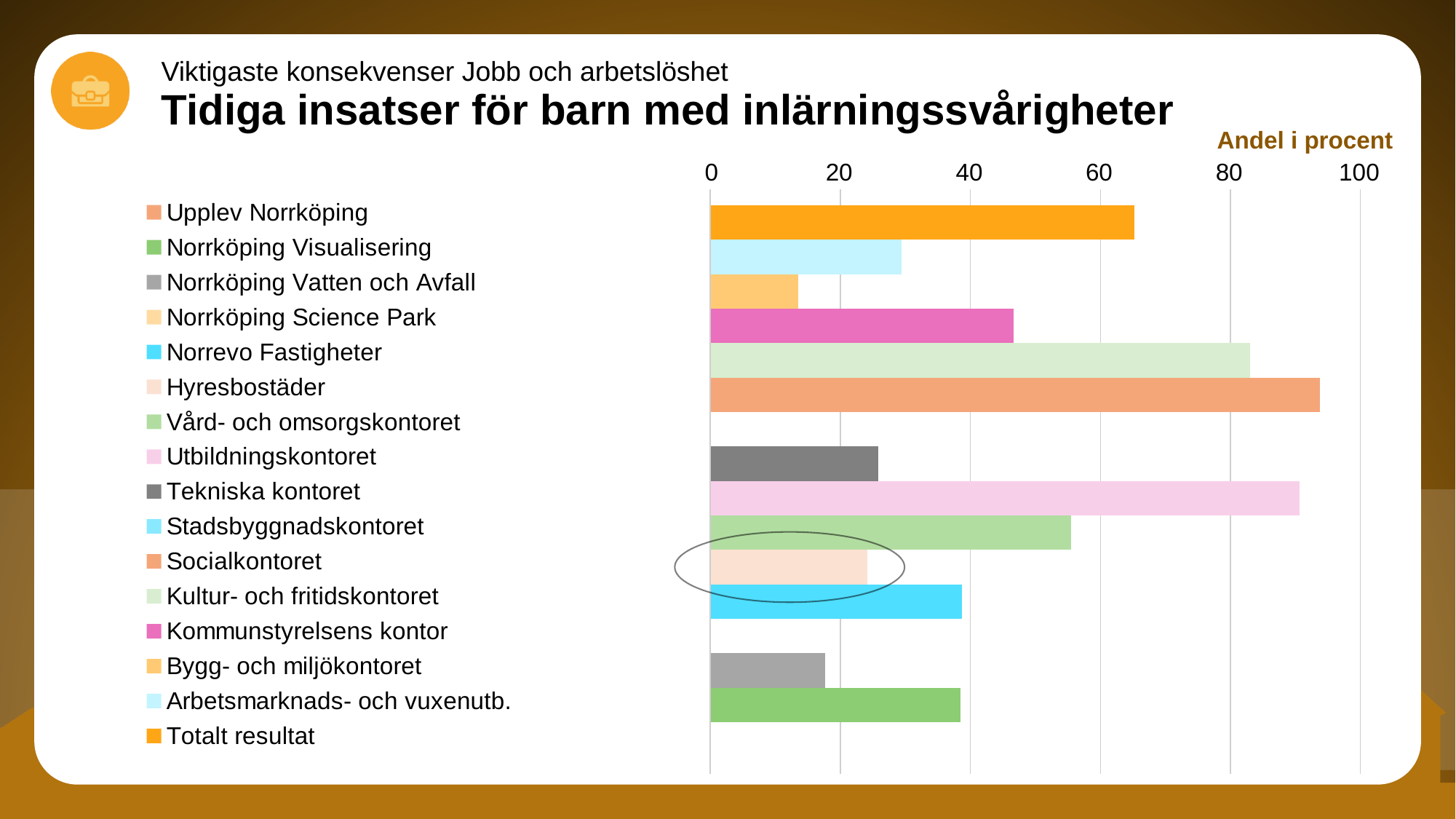
Is the value for Arbetsmarknads- och vuxenutb. greater or less than 40? less Is the value for Bygg- och miljökontoret greater or less than 20? less Is the value for Kommunstyrelsens kontor greater or less than 40? greater What kind of chart is shown on the slide? bar chart How many entries does the chart legend list? 16 Which has the larger value, Kommunstyrelsens kontor or Bygg- och miljökontoret? Kommunstyrelsens kontor What is the axis title shown above the horizontal axis? Andel i procent Which has the larger value, Utbildningskontoret or Vård- och omsorgskontoret? Utbildningskontoret Which has the larger value, Socialkontoret or Tekniska kontoret? Socialkontoret